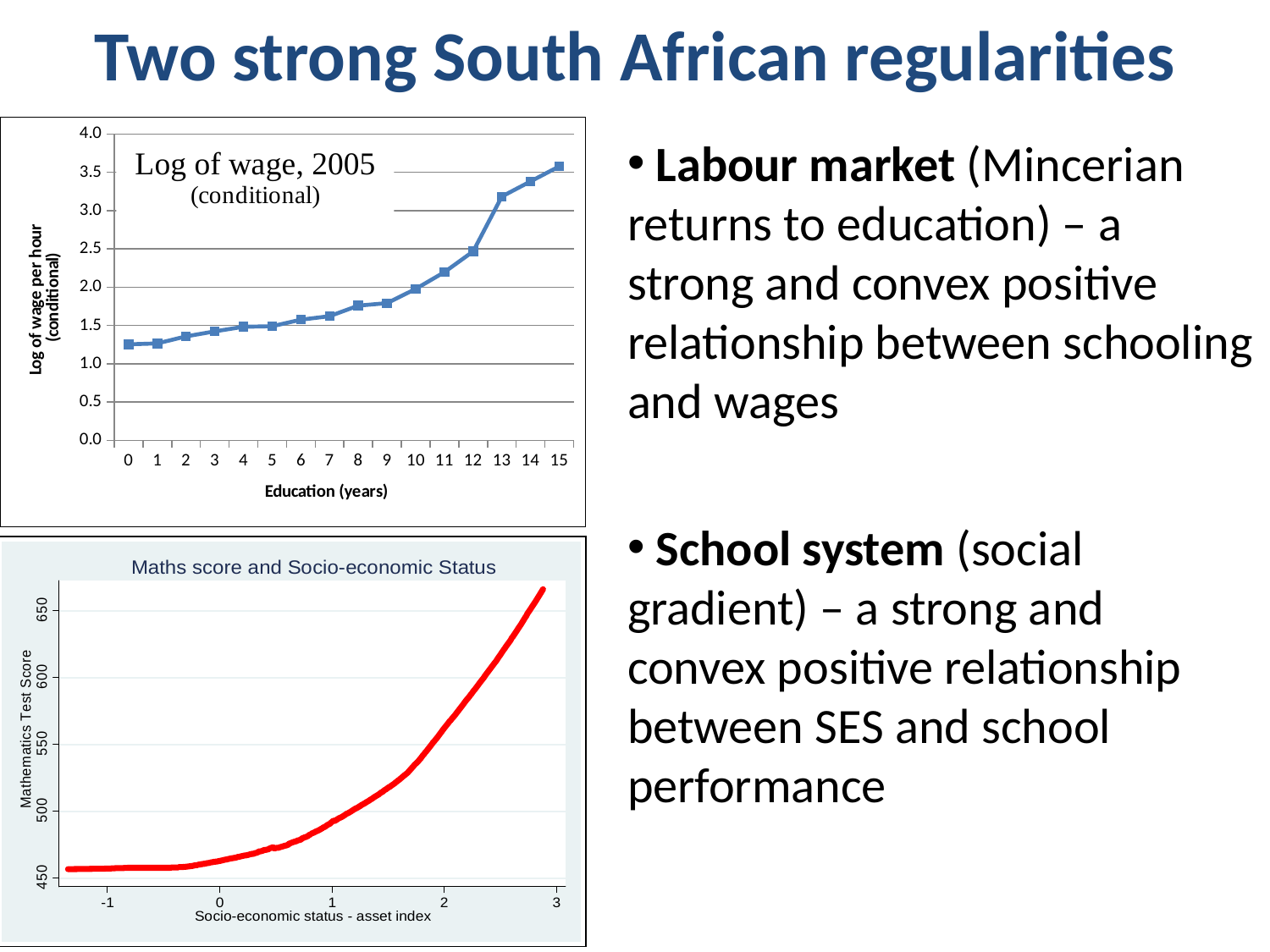
In the top chart 'Log of wage, 2005 (conditional)', how many education-year categories are shown on the x axis? 16 What is the x-axis label of the top chart 'Log of wage, 2005 (conditional)'? Education (years) In the top chart 'Log of wage, 2005 (conditional)', is the value for 13 years of education greater or less than 3.0? greater In the top chart 'Log of wage, 2005 (conditional)', is the value for 8 years of education greater or less than 1.5? greater In the bottom chart 'Maths score and Socio-economic Status', is the maths score at an asset index of 0 greater or less than 500? less In the top chart 'Log of wage, 2005 (conditional)', which is larger: the value for 14 years of education or the value for 9 years? 14 years What kind of chart is the top chart, 'Log of wage, 2005 (conditional)'? line chart In the top chart 'Log of wage, 2005 (conditional)', which education level has the highest log of wage? 15 In the top chart 'Log of wage, 2005 (conditional)', do the values rise or fall as education years increase? rise In the bottom chart 'Maths score and Socio-economic Status', does the maths score rise or fall as the socio-economic status asset index increases? rise